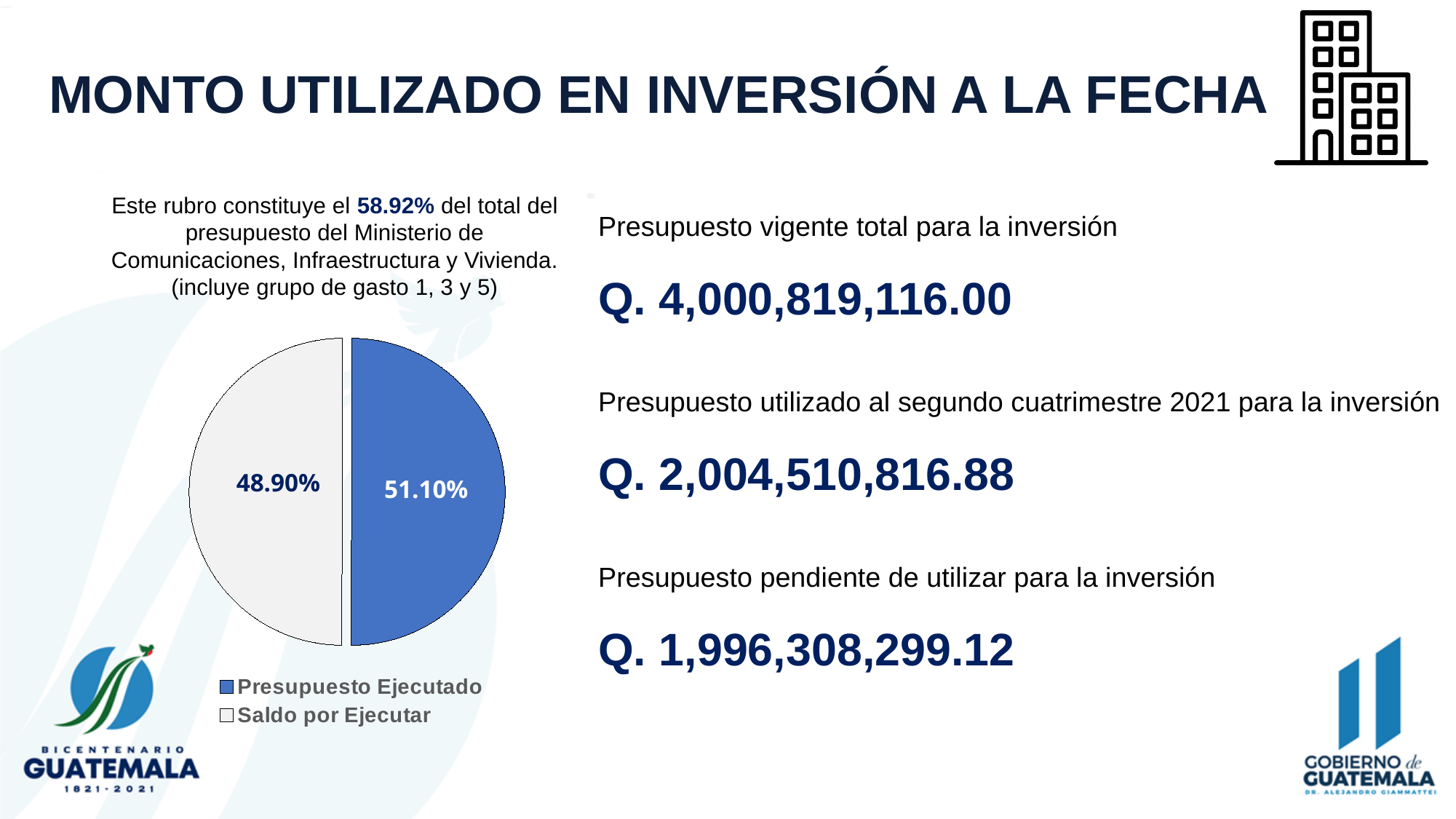
How many entries does the legend list? 2 What kind of chart is shown on the slide? pie chart Which slice of the pie is the largest? Presupuesto Ejecutado How many slices does the pie chart have? 2 What is the difference in percentage points between Presupuesto Ejecutado and Saldo por Ejecutar? 2.20% What share of the pie does Presupuesto Ejecutado represent? 51.10% What colour is the Presupuesto Ejecutado slice? blue What share of the pie does Saldo por Ejecutar represent? 48.90% Which slice of the pie is the smallest? Saldo por Ejecutar Which is larger, Presupuesto Ejecutado or Saldo por Ejecutar? Presupuesto Ejecutado Which legend entry is shown in white/grey? Saldo por Ejecutar Is the value for Presupuesto Ejecutado greater or less than 50%? greater